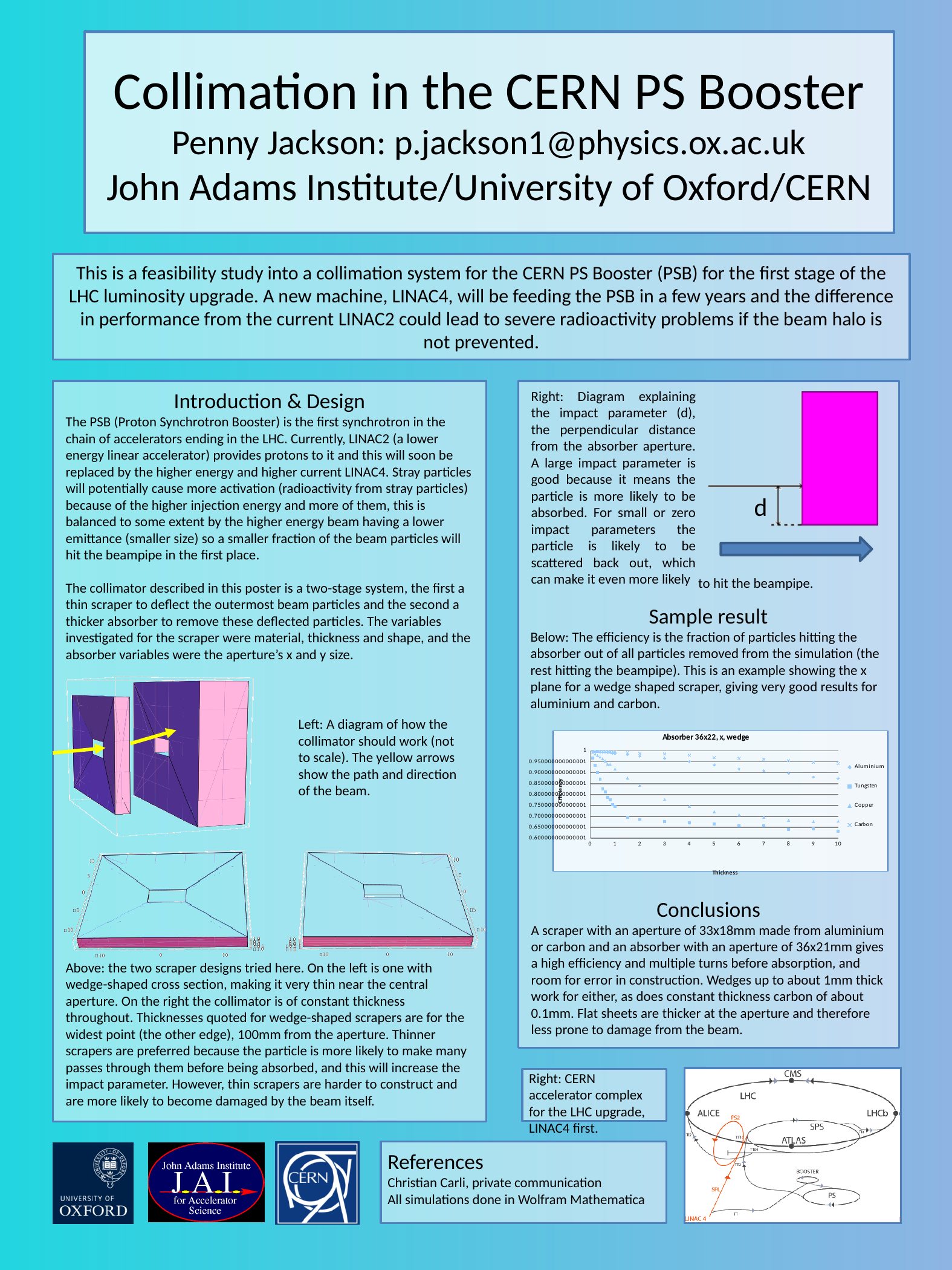
Which materials are listed in the legend of the 'Absorber 36x22, x, wedge' chart? Aluminium, Tungsten, Copper, Carbon In the 'Absorber 36x22, x, wedge' chart, which series has the lowest efficiency values at large thicknesses? Tungsten In the 'Absorber 36x22, x, wedge' chart, which series has higher efficiency at a thickness of 8: Copper or Tungsten? Copper In the 'Absorber 36x22, x, wedge' chart, is the Tungsten efficiency at a thickness of 5 greater or less than 0.7? less What kind of chart is shown under the 'Sample result' section? scatter chart How many series does the legend of the 'Absorber 36x22, x, wedge' chart list? 4 What is the label of the x axis of the 'Absorber 36x22, x, wedge' chart? Thickness What is the highest value shown on the x axis of the 'Absorber 36x22, x, wedge' chart? 10 In the 'Absorber 36x22, x, wedge' chart, which series has higher efficiency at a thickness of 5: Carbon or Tungsten? Carbon In the 'Absorber 36x22, x, wedge' chart, is the Carbon efficiency at a thickness of 5 greater or less than 0.9? greater In the 'Absorber 36x22, x, wedge' chart, does the efficiency generally rise or fall as thickness increases? fall